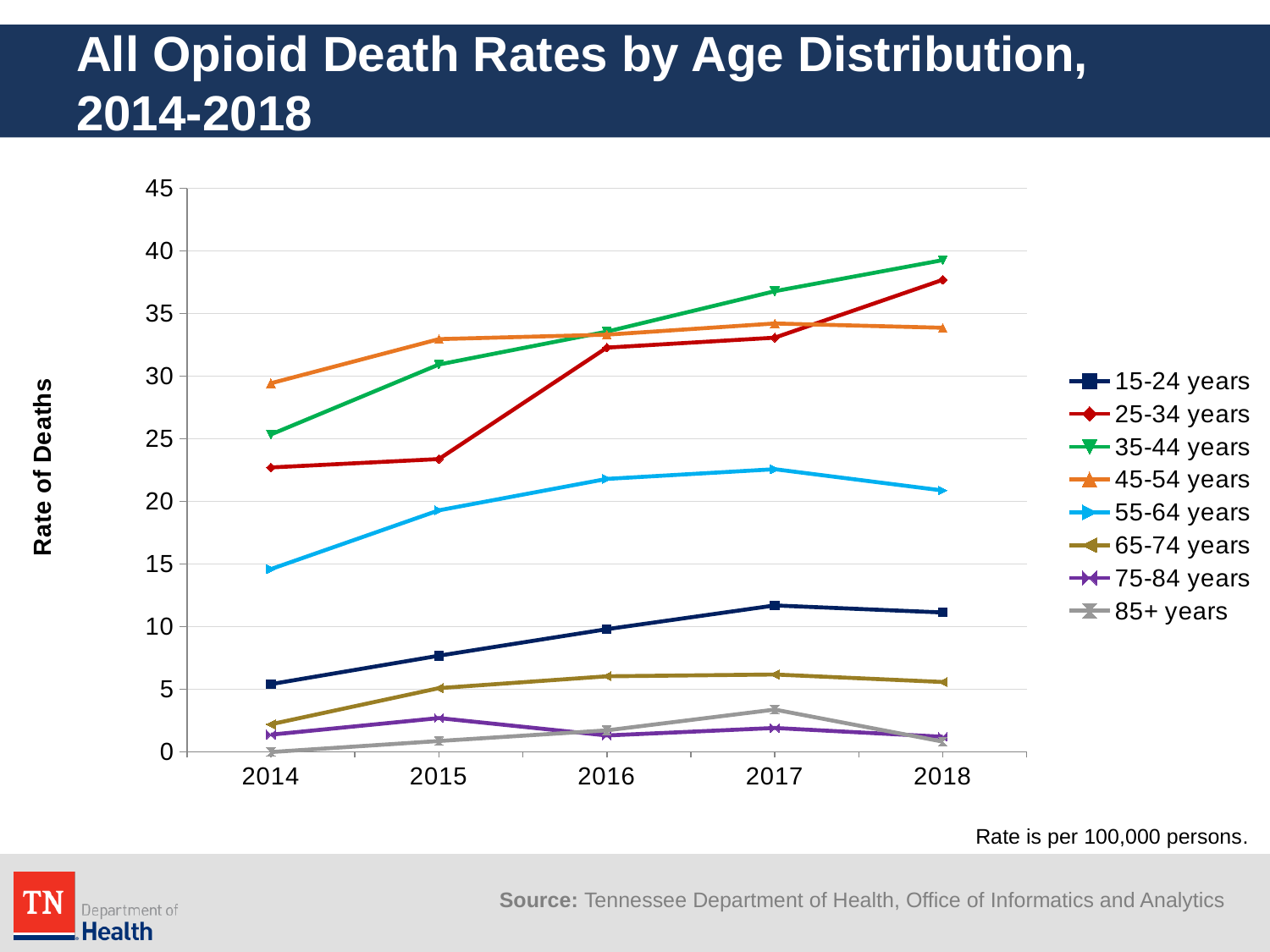
Which age group has the highest opioid death rate in 2014? 45-54 years What kind of chart is shown on the slide? Line chart How many age-group series does the legend list? 8 Does the death rate for 35-44 years rise or fall from 2014 to 2018? rise In 2016, which has the larger death rate: 25-34 years or 55-64 years? 25-34 years Is the value for 55-64 years in 2017 greater or less than 20? greater Is the value for 15-24 years in 2014 greater or less than 10? less What is the label on the y axis of the chart? Rate of Deaths How many years are plotted along the x axis? 5 Which age group has the highest opioid death rate in 2018? 35-44 years Which age group has the lowest opioid death rate in 2014? 85+ years In 2018, which has the larger death rate: 15-24 years or 65-74 years? 15-24 years